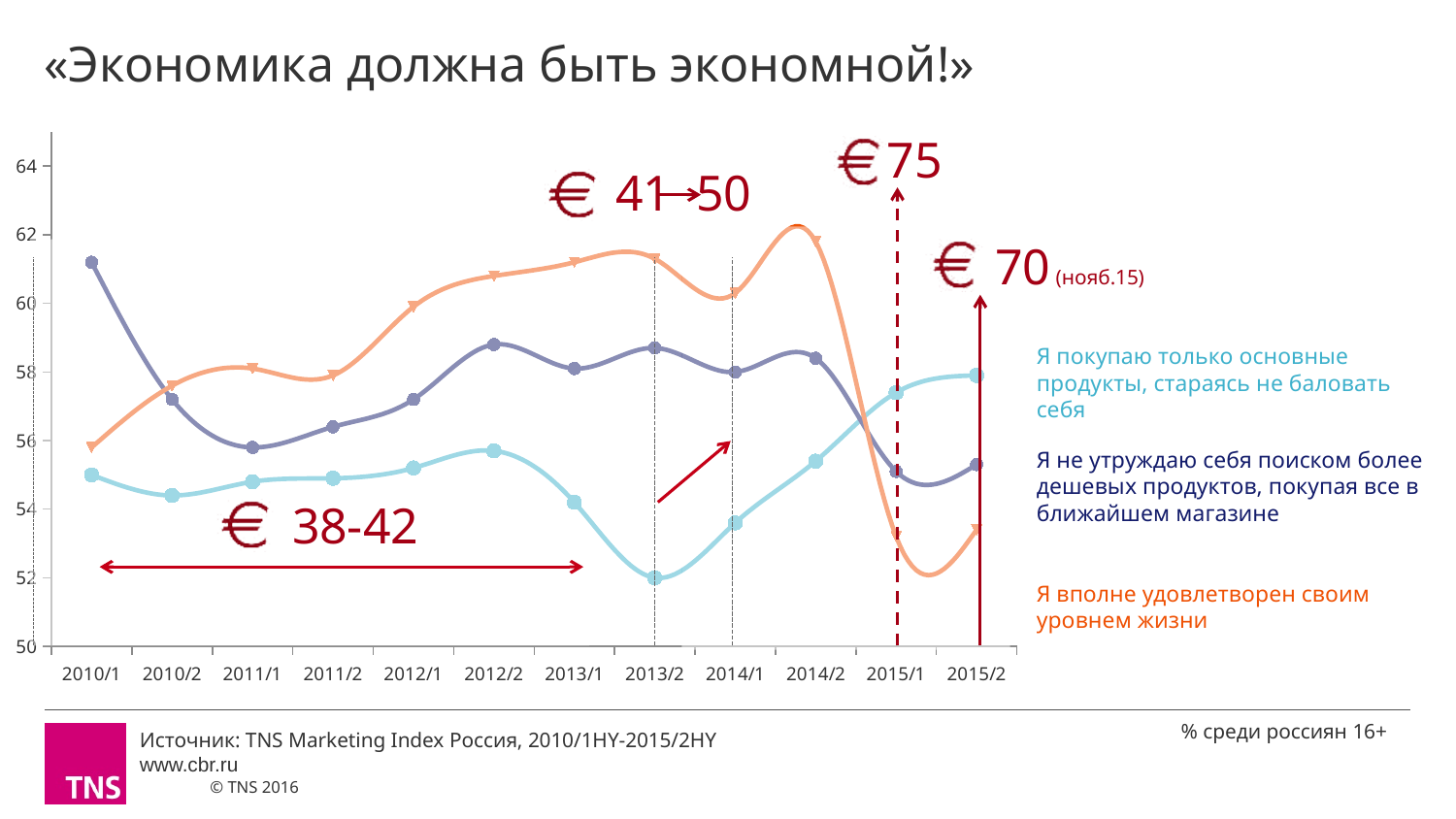
What kind of chart is shown on the slide? line chart Is the value of the light blue series (Я покупаю только основные продукты) at 2013/2 greater or less than 54? less Is the value of the orange series (Я вполне удовлетворен своим уровнем жизни) at 2014/2 greater or less than 60? greater At 2010/1, which series has the higher value: the dark blue series or the orange series? the dark blue series Is the value of the orange series at 2015/1 greater or less than 54? less How many time periods are shown on the x axis of the chart? 12 In which period does the light blue series (Я покупаю только основные продукты) reach its lowest value? 2013/2 What is the title of the slide? «Экономика должна быть экономной!» How many series are plotted on the chart? 3 Does the orange series rise or fall between 2014/2 and 2015/1? fall In which period does the orange series (Я вполне удовлетворен своим уровнем жизни) reach its highest value? 2014/2